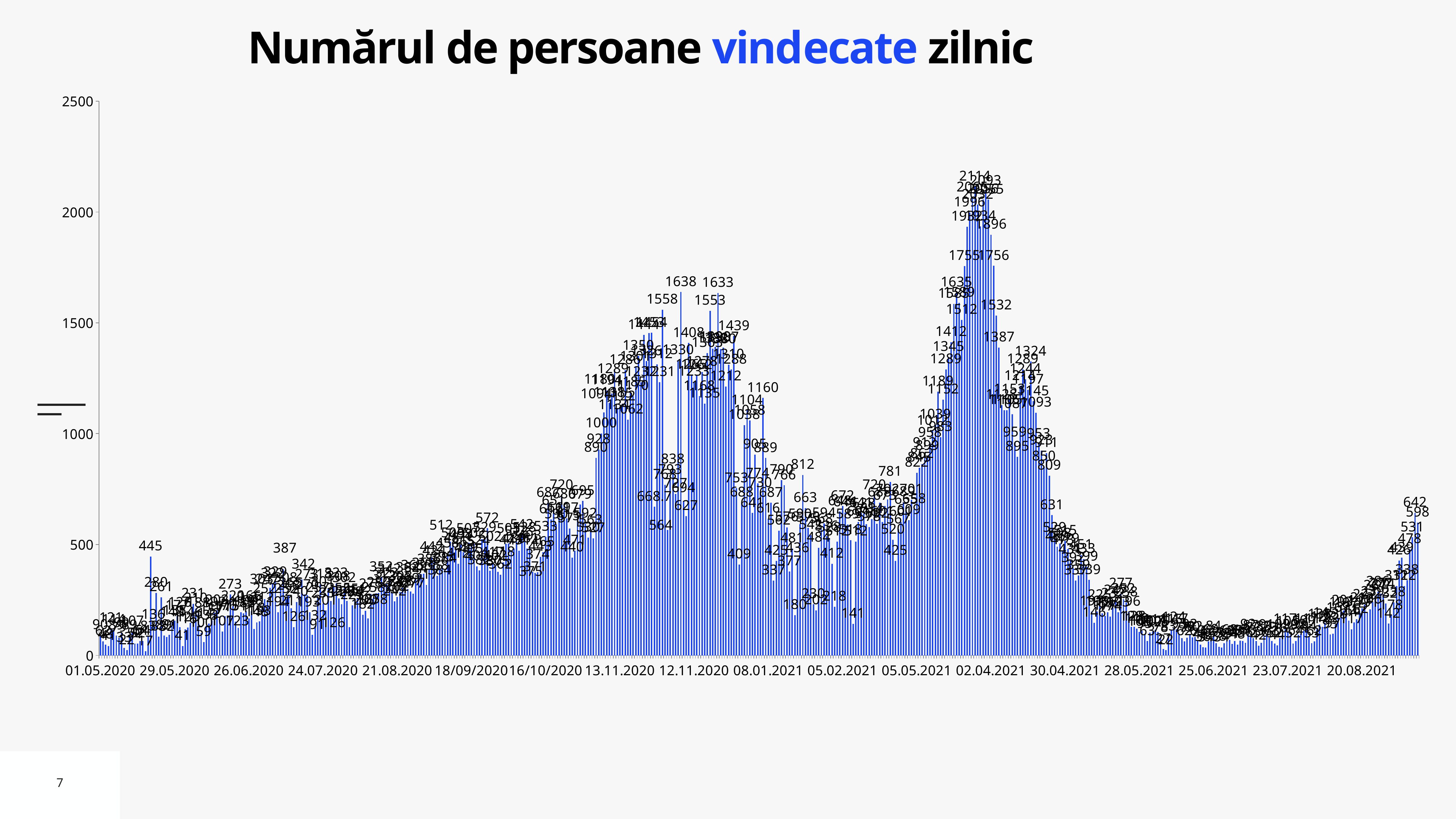
Which peak is higher: the one around 12.11.2020 or the one around 02.04.2021? the one around 02.04.2021 What is the title of the chart? Numărul de persoane vindecate zilnic Between 02.04.2021 and 28.05.2021, do the values generally rise or fall? fall Between 25.06.2021 and the end of the chart, do the values generally rise or fall? rise Is the value for 01.05.2020 greater or less than 500? less What is the highest value labeled in the peak around 12.11.2020? 1638 Is the tallest bar on the chart greater or less than 2000? greater What is the highest value labeled on the chart? 2114 What is the value of the spike just before 24.07.2020? 387 What is the highest tick value shown on the vertical axis? 2500 What kind of chart is shown on the slide? bar chart What is the value of the isolated spike just before 29.05.2020? 445